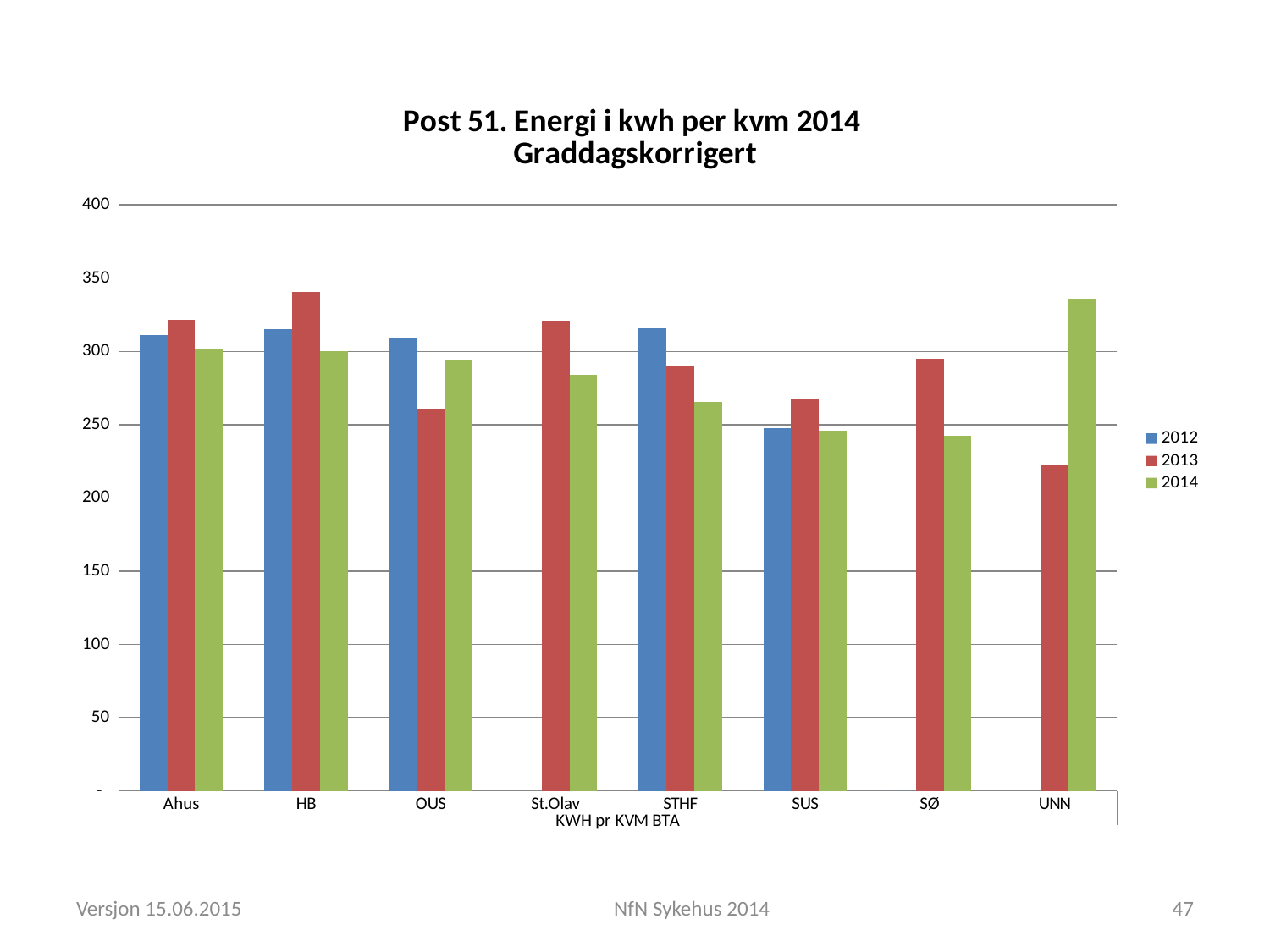
Which category has the highest value for the 2014 series? UNN Is the 2013 value for UNN greater or less than 250? less Which category has the highest value for the 2013 series? HB How many categories are shown on the x axis? 8 Is the 2013 value for HB greater or less than 300? greater Which category has the lowest value for the 2013 series? UNN How many series does the legend list? 3 Is the 2014 value for SØ greater or less than 250? less What is the title of the chart? Post 51. Energi i kwh per kvm 2014 Graddagskorrigert For OUS, which is larger: the 2012 value or the 2013 value? 2012 For UNN, which is larger: the 2013 value or the 2014 value? 2014 What kind of chart is shown on the slide? Bar chart